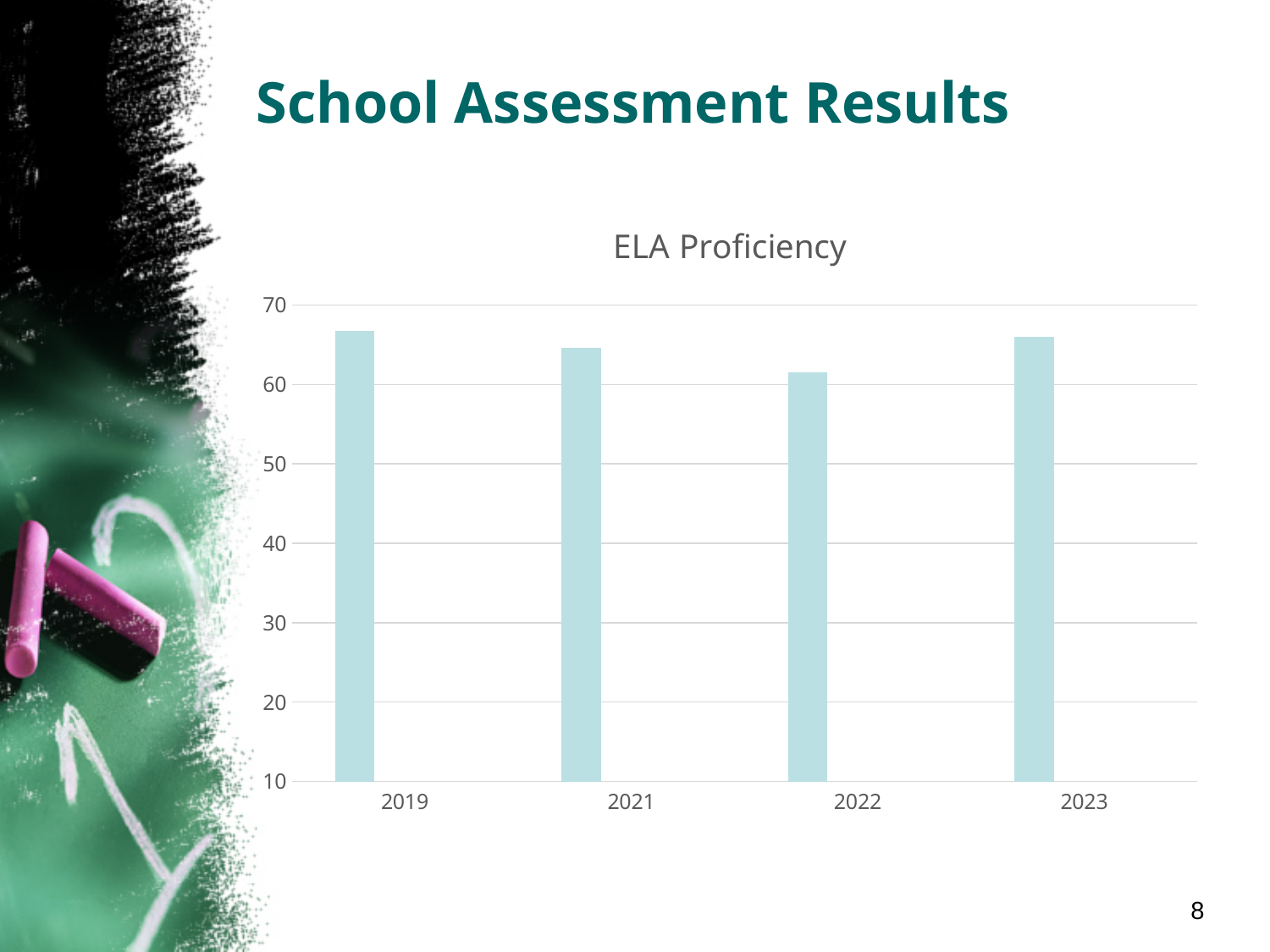
What is the title of the slide containing the chart? School Assessment Results Is the ELA Proficiency value for 2022 greater or less than 70? less Do the ELA Proficiency values rise or fall from 2019 to 2022? fall Which year has the larger ELA Proficiency value, 2019 or 2022? 2019 How many years are shown on the x axis of the chart? 4 Which year has the larger ELA Proficiency value, 2021 or 2022? 2021 Is the ELA Proficiency value for 2021 greater or less than 60? greater What kind of chart is shown on the slide? bar chart What is the title of the chart? ELA Proficiency Is the ELA Proficiency value for 2019 greater or less than 60? greater Which year has the lowest ELA Proficiency value? 2022